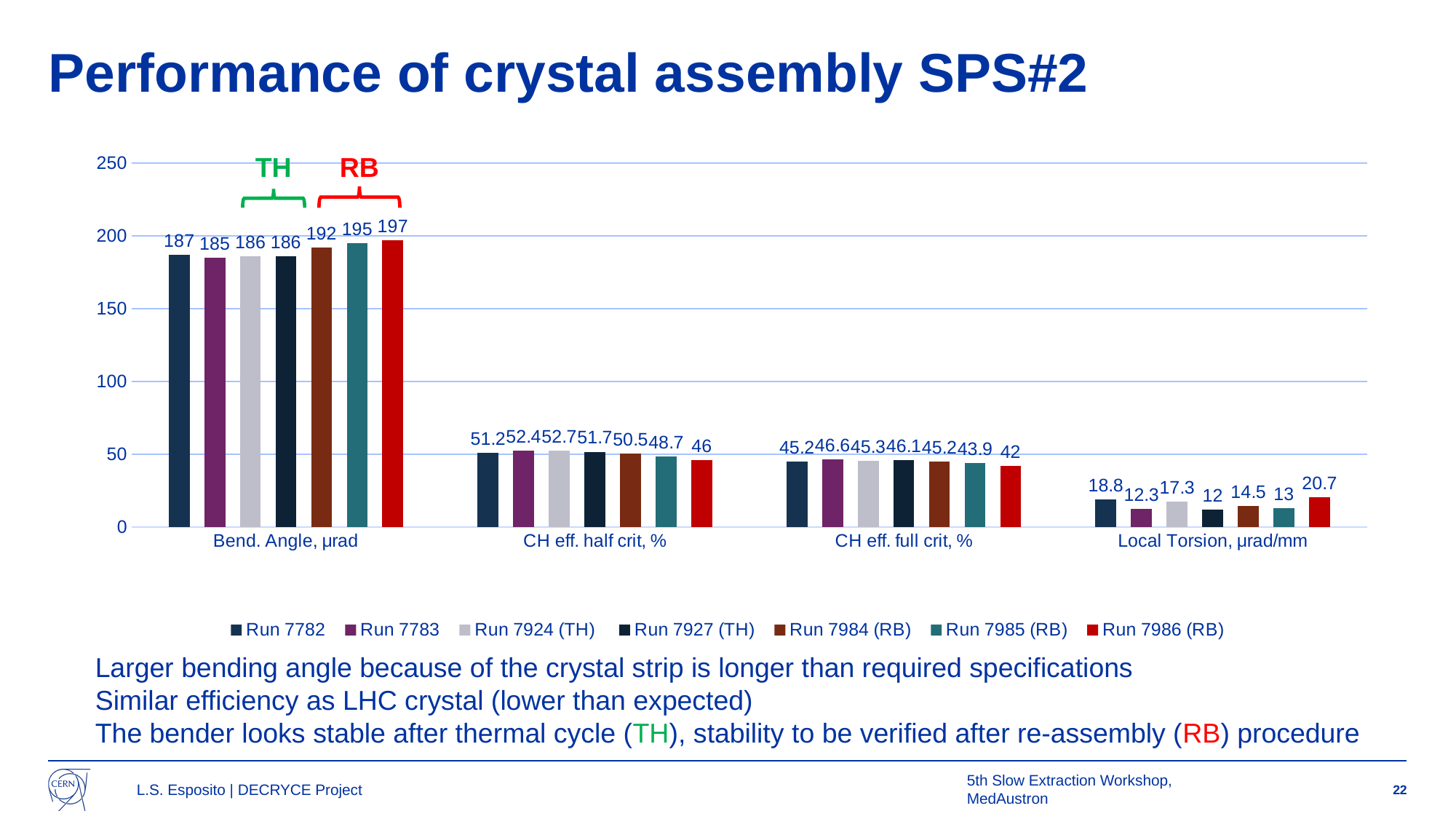
Which run has the highest Bend. Angle, µrad value? Run 7986 (RB) How many categories are shown on the x axis of the chart? 4 What kind of chart is shown on the slide? bar chart Is the Bend. Angle, µrad value for Run 7782 greater or less than 150? greater Which has the larger CH eff. half crit, % value: Run 7924 (TH) or Run 7986 (RB)? Run 7924 (TH) What is the Local Torsion, µrad/mm value for Run 7783? 12.3 What is the difference between the Bend. Angle, µrad values for Run 7986 (RB) and Run 7783? 12 What is the CH eff. half crit, % value for Run 7985 (RB)? 48.7 How many series does the legend list? 7 What is the Bend. Angle, µrad value for Run 7986 (RB)? 197 Which run has the lowest CH eff. full crit, % value? Run 7986 (RB) What is the difference between the Local Torsion, µrad/mm values for Run 7986 (RB) and Run 7927 (TH)? 8.7